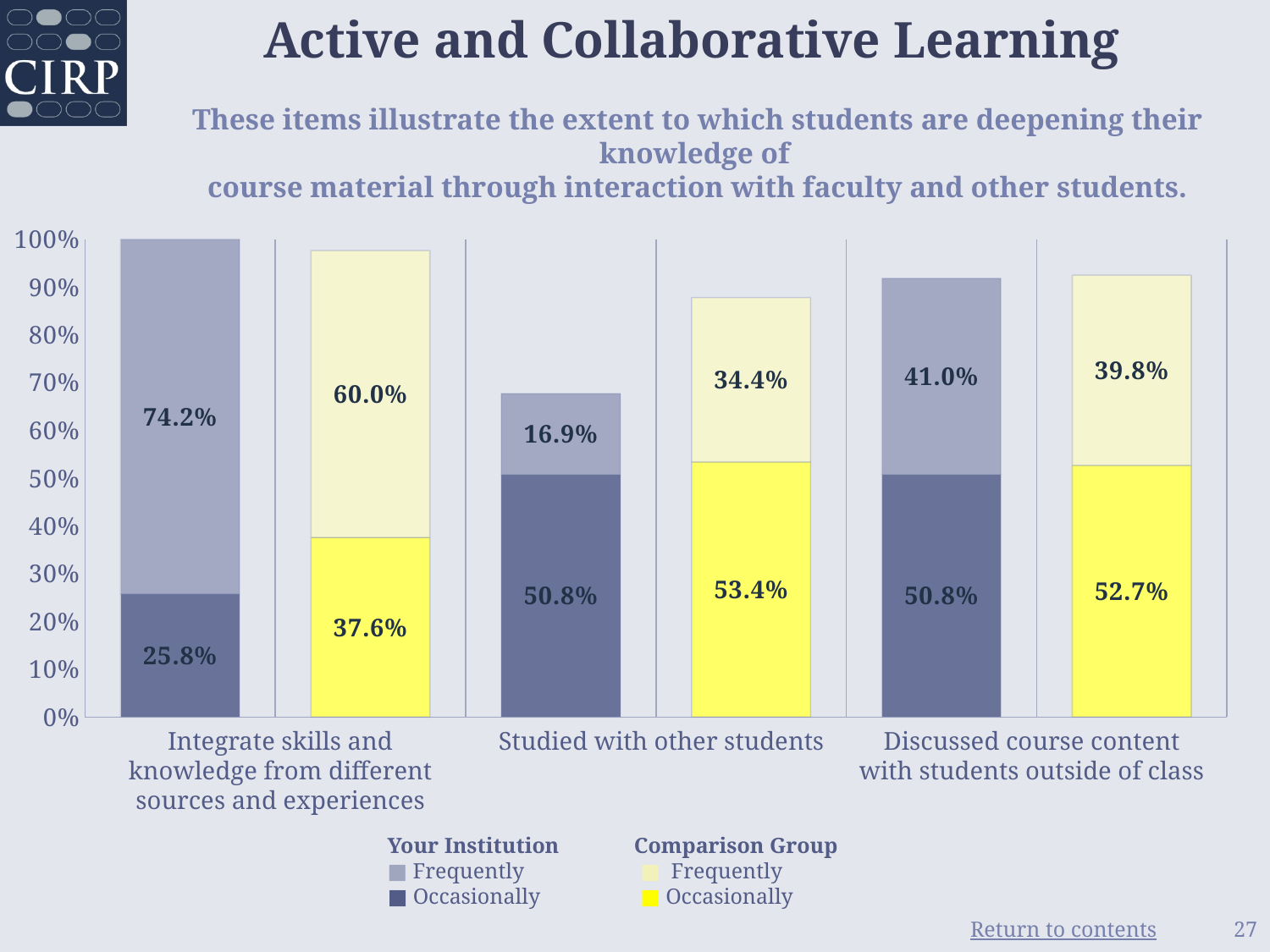
What is the total height of the Your Institution stacked bar for 'Studied with other students'? 67.7% Which item has the highest 'Frequently' value for the Comparison Group? Integrate skills and knowledge from different sources and experiences What is the Comparison Group's 'Occasionally' value for 'Studied with other students'? 53.4% What percentage of students at Your Institution reported 'Frequently' integrating skills and knowledge from different sources and experiences? 74.2% What is the difference between the Comparison Group's and Your Institution's 'Frequently' values for 'Studied with other students'? 17.5% For 'Integrate skills and knowledge from different sources and experiences', which is larger: Your Institution's 'Frequently' value or the Comparison Group's 'Frequently' value? Your Institution What type of chart is shown on the slide? Stacked bar chart Across the three items, which has the lowest 'Frequently' value for Your Institution? Studied with other students What is the total of the Comparison Group stacked bar for 'Discussed course content with students outside of class'? 92.5% How many entries does the legend list? 4 How many items (categories) are shown on the x axis of the chart? 3 What is the 'Frequently' value for Your Institution for 'Discussed course content with students outside of class'? 41.0%